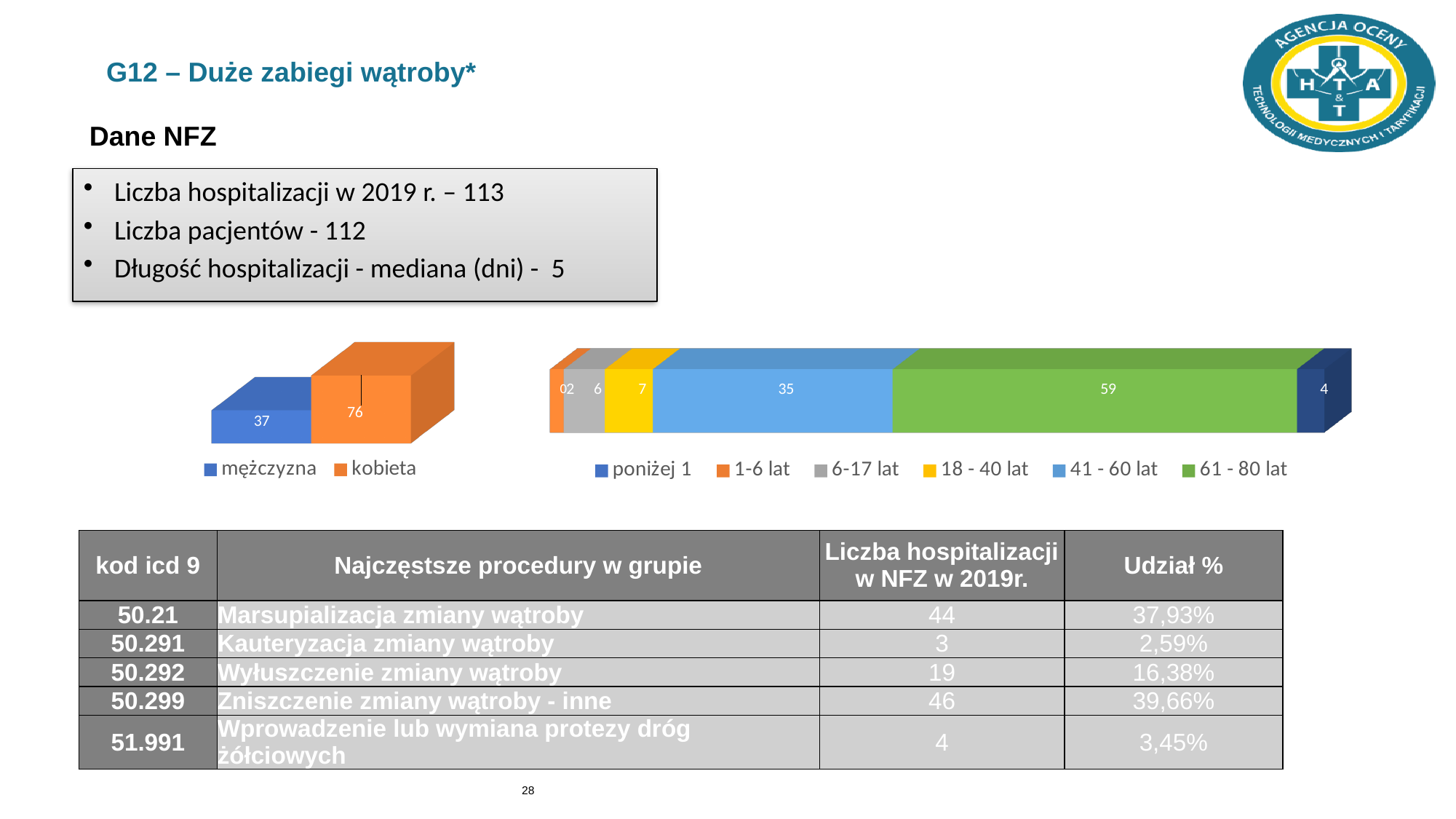
In the right chart (age groups), what is the value for 6-17 lat? 6 In the right chart (age groups), which age group listed in the legend has the highest value? 61 - 80 lat In the left chart (mężczyzna / kobieta), what is the difference between the value for kobieta and the value for mężczyzna? 39 What kind of chart is the left chart showing mężczyzna and kobieta? bar chart How many entries does the legend of the left chart (mężczyzna / kobieta) list? 2 In the right chart (age groups), what is the value for 41 - 60 lat? 35 In the right chart (age groups), what is the value for 61 - 80 lat? 59 In the right chart (age groups), what is the value for 18 - 40 lat? 7 In the left chart (mężczyzna / kobieta), which category has the higher value? kobieta In the left chart (mężczyzna / kobieta), what is the value for mężczyzna? 37 In the left chart (mężczyzna / kobieta), what is the value for kobieta? 76 In the right chart (age groups), what is the difference between the value for 61 - 80 lat and the value for 41 - 60 lat? 24